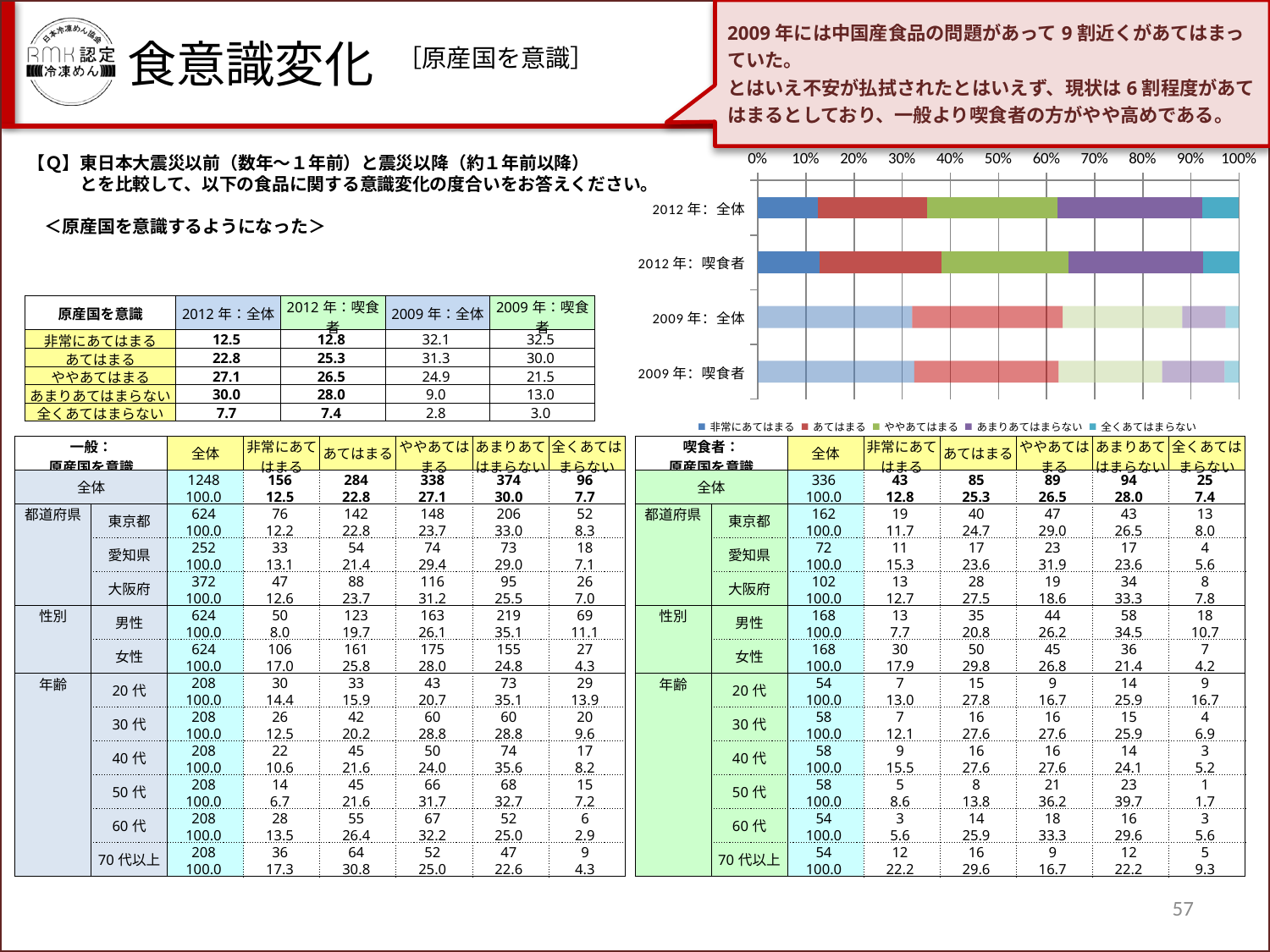
What is the first entry in the chart legend? 非常にあてはまる What kind of chart is shown on the slide? stacked bar chart How many bars (categories) does the chart show? 4 How many series does the chart legend list? 5 Is the 非常にあてはまる segment for 2009年: 全体 greater or less than 20%? greater Which bar has the larger 非常にあてはまる segment, 2012年: 全体 or 2009年: 全体? 2009年: 全体 Which bar has the larger あまりあてはまらない segment, 2012年: 喫食者 or 2009年: 喫食者? 2012年: 喫食者 What is the maximum value shown on the chart's horizontal axis? 100% Is the 非常にあてはまる segment for 2012年: 全体 greater or less than 20%? less Which bar has the larger 全くあてはまらない segment, 2012年: 全体 or 2009年: 全体? 2012年: 全体 Is the combined share of 非常にあてはまる and あてはまる for 2012年: 全体 greater or less than 50%? less